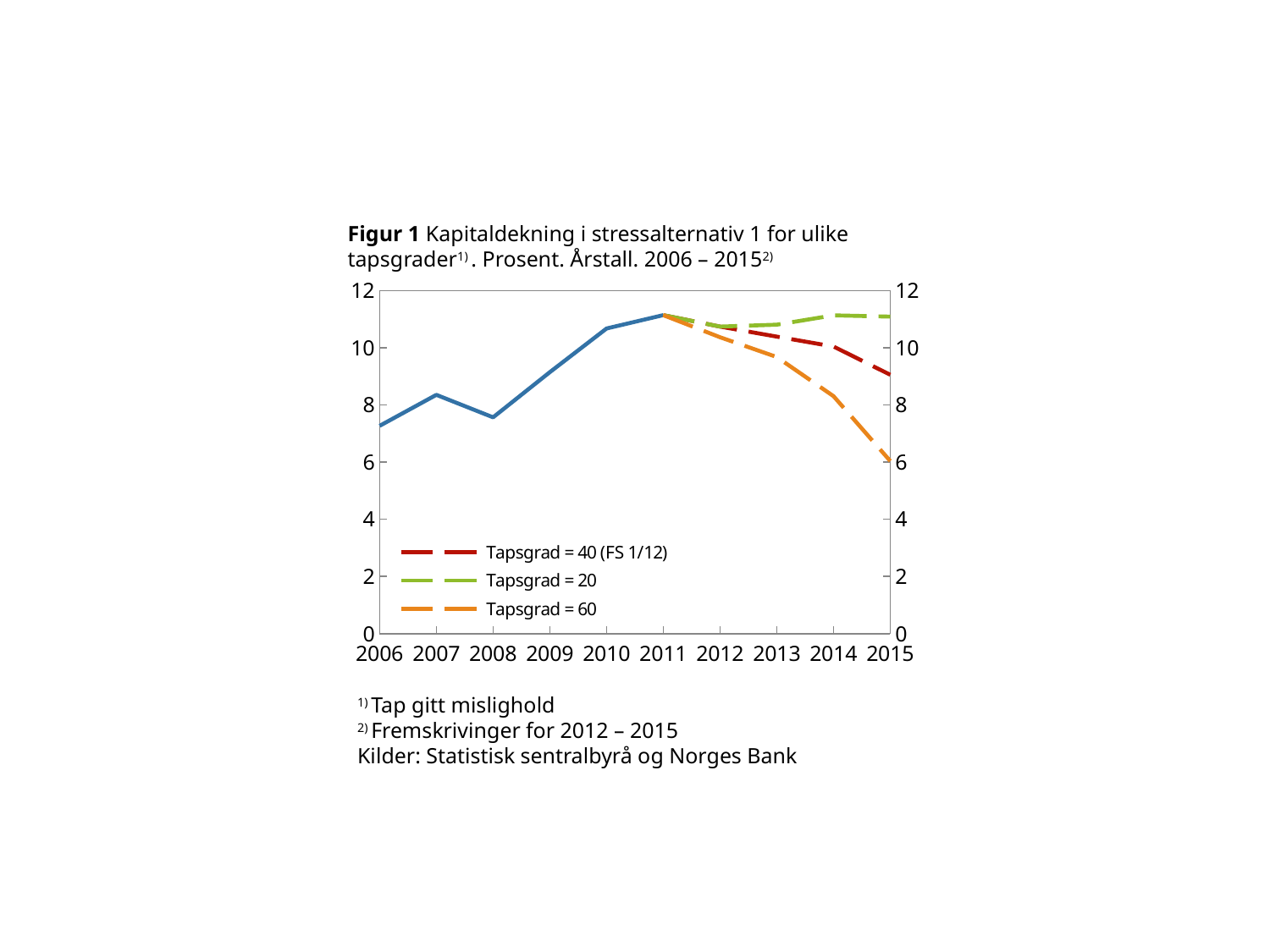
Which series has the lowest value in 2015? Tapsgrad = 60 Is the value for 2010 greater or less than 10? greater Which series is drawn with a dashed orange line? Tapsgrad = 60 Which series has the highest value in 2015? Tapsgrad = 20 Which is larger, the value for 2007 or the value for 2008? 2007 Is the value for 2006 greater or less than 8? less Does the Tapsgrad = 60 series rise or fall from 2011 to 2015? fall What kind of chart is shown in Figur 1? line chart Is the value for Tapsgrad = 20 in 2015 greater or less than 10? greater How many series does the legend list? 3 How many years are labelled on the x axis? 10